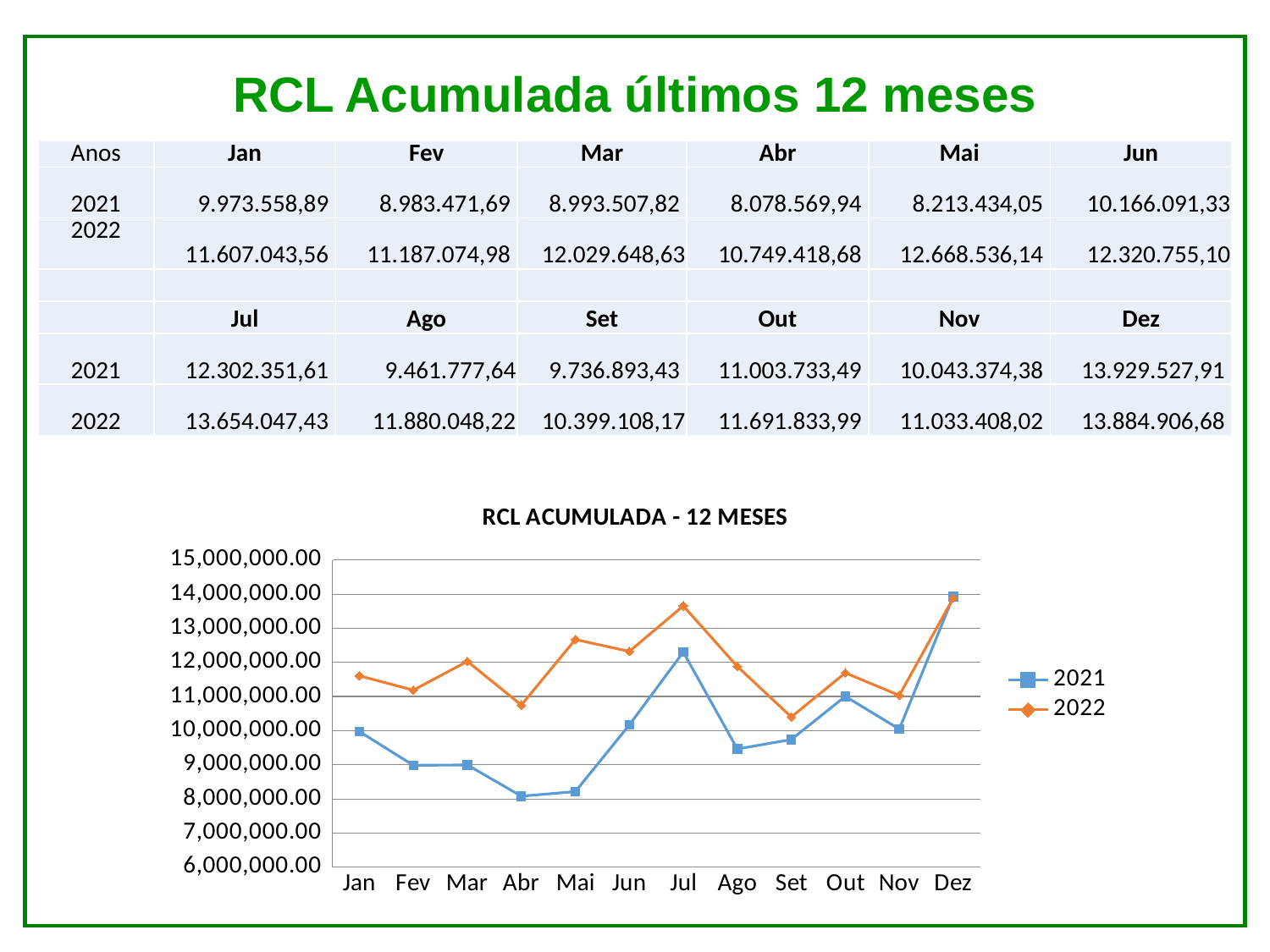
How many series does the chart legend list? 2 In which month does the 2021 series reach its highest value? Dez What is the RCL acumulada value for Dez 2021? 13.929.527,91 In Jul, which series has the larger value, 2021 or 2022? 2022 What is the RCL acumulada value for Jan 2022? 11.607.043,56 Is the value for Jul 2022 greater or less than 13,000,000.00? greater What is the title of the chart? RCL ACUMULADA - 12 MESES What kind of chart is shown on the slide? line chart In which month does the 2022 series reach its lowest value? Set Is the value for Abr 2021 greater or less than 9,000,000.00? less How many months are plotted along the x axis of the chart? 12 What is the difference between the Jan 2022 value and the Jan 2021 value? 1.633.484,67